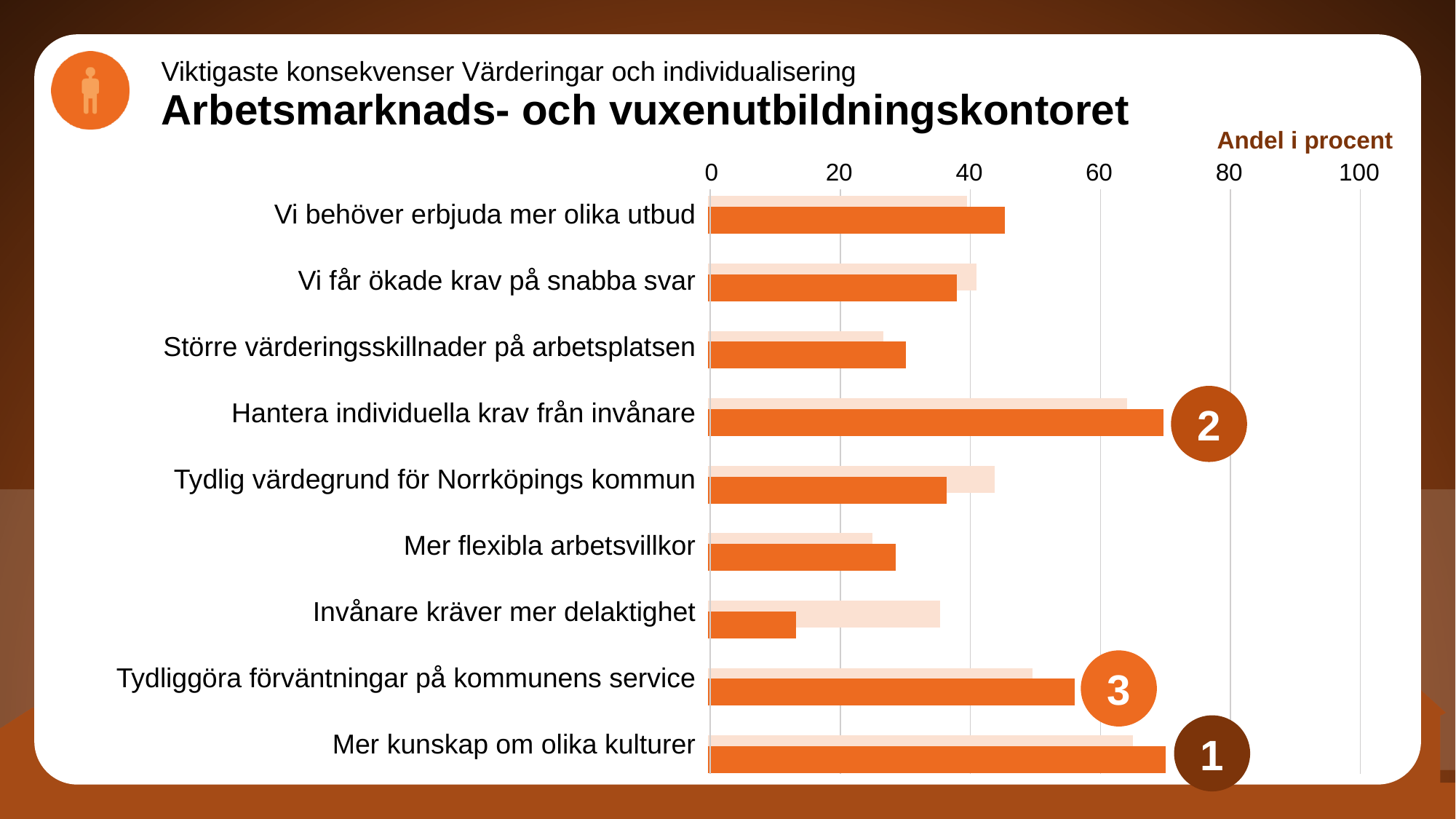
Which has the longer dark orange bar: "Tydliggöra förväntningar på kommunens service" or "Tydlig värdegrund för Norrköpings kommun"? Tydliggöra förväntningar på kommunens service Is the dark orange bar for "Invånare kräver mer delaktighet" greater or less than 20? less Is the dark orange bar for "Mer kunskap om olika kulturer" greater or less than 80? less Is the dark orange bar for "Tydliggöra förväntningar på kommunens service" greater or less than 40? greater Which has the longer dark orange bar: "Vi behöver erbjuda mer olika utbud" or "Större värderingsskillnader på arbetsplatsen"? Vi behöver erbjuda mer olika utbud What kind of chart is shown on the slide? bar chart What is the highest value shown on the horizontal axis of the chart? 100 Which category has the shortest dark orange bar? Invånare kräver mer delaktighet How many categories are listed on the vertical axis of the chart? 9 What label is shown above the horizontal axis of the chart? Andel i procent